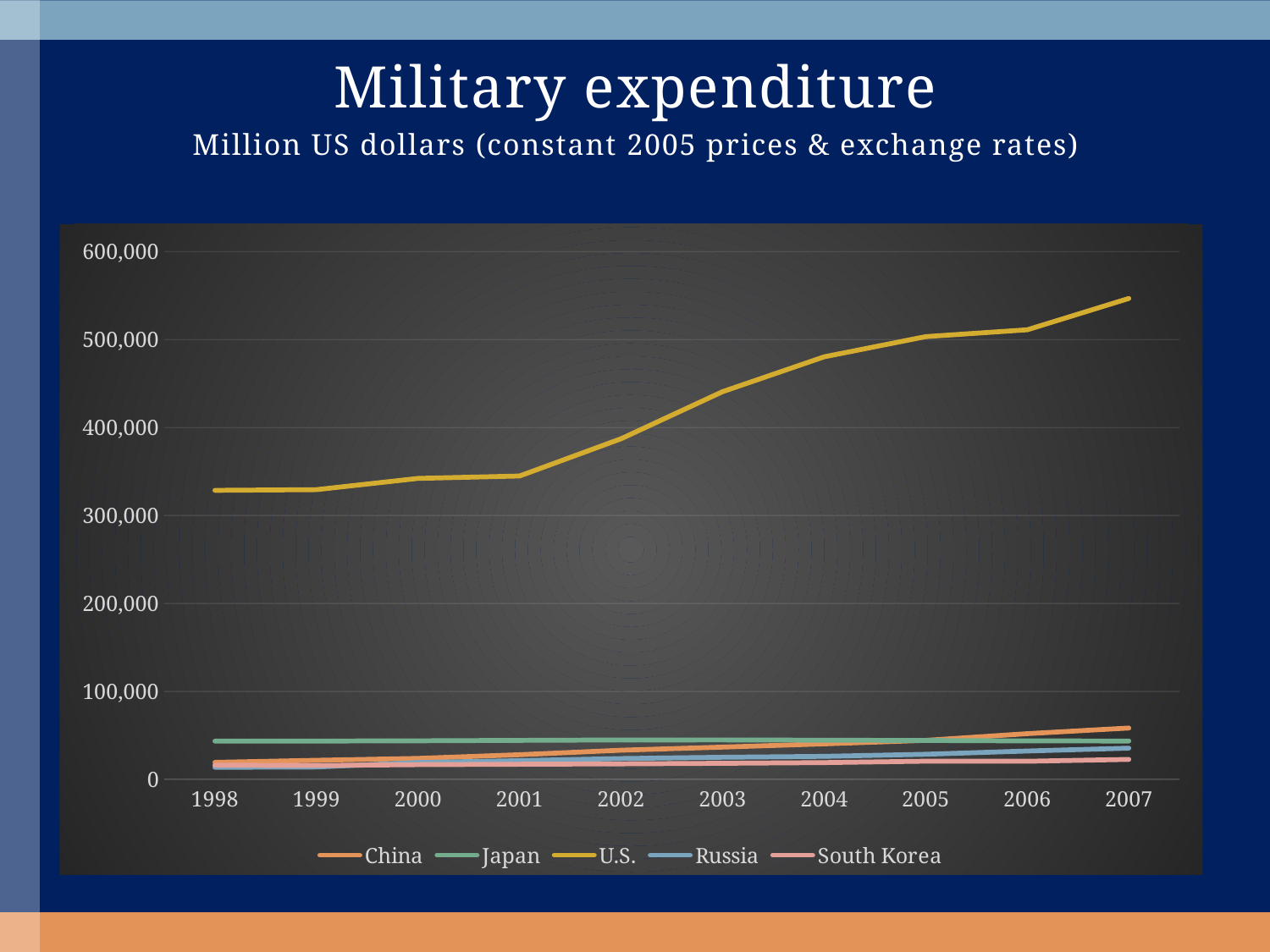
What kind of chart is shown on the slide? line chart Which is larger in 1998, the value for Japan or the value for China? Japan Which country has the highest military expenditure across the chart? U.S. Is the value for the U.S. in 2001 greater or less than 400,000? less Is the value for Japan in 2007 greater or less than 100,000? less How many series does the legend list? 5 Is the value for the U.S. in 1998 greater or less than 300,000? greater Does the U.S. military expenditure rise or fall from 1998 to 2007? rise How many years are shown along the x axis? 10 What is the title of the chart? Military expenditure